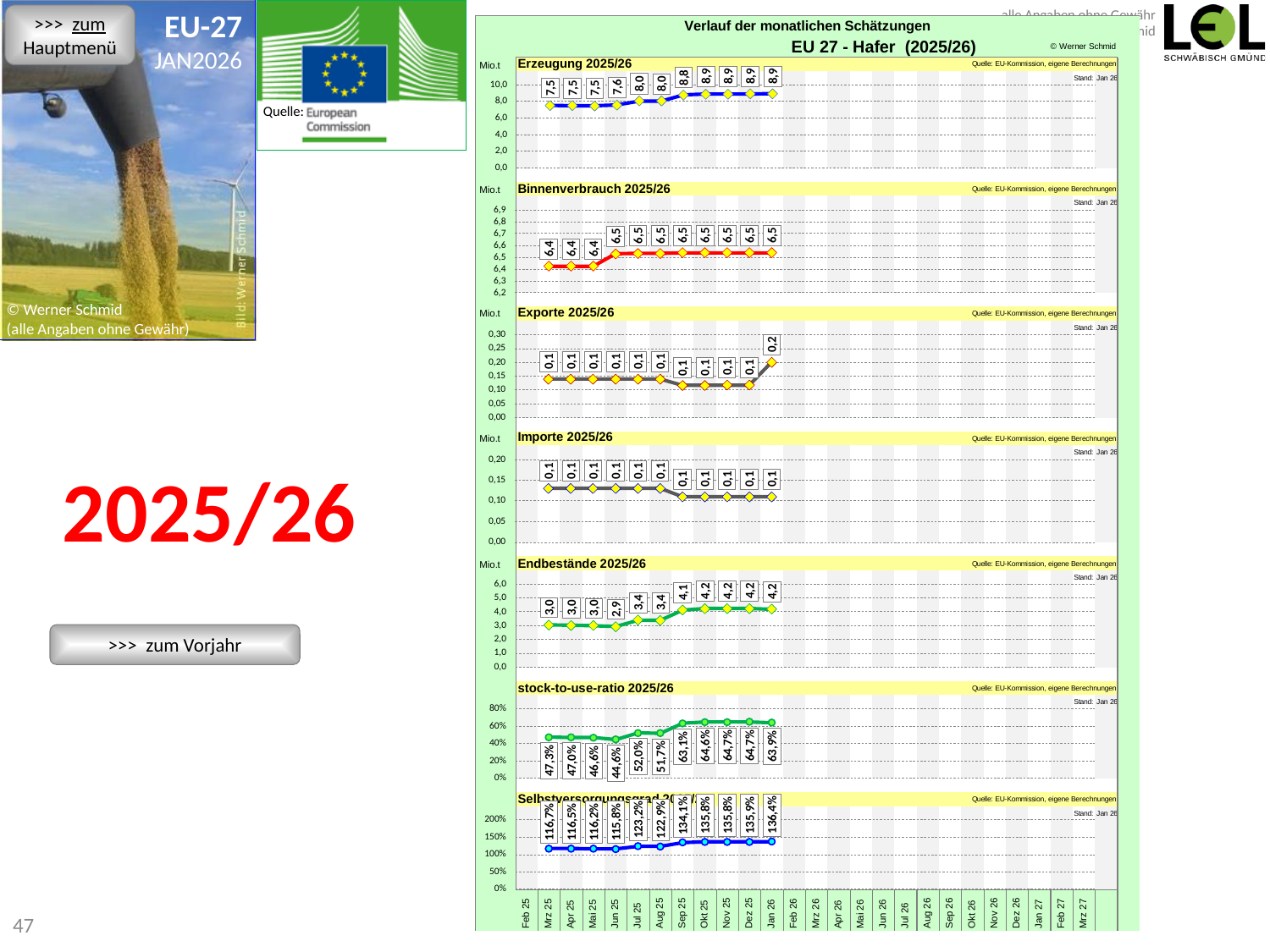
In the stock-to-use-ratio 2025/26 chart, what is the value for Jan 26? 63,9% What kind of charts are shown on the slide? Line charts In the Erzeugung 2025/26 chart, what is the difference between the Jan 26 value (8,9) and the first value in Mrz 25 (7,5)? 1,4 What is the overall title above the charts? EU 27 - Hafer (2025/26) In the Binnenverbrauch 2025/26 chart, what is the value for Jan 26? 6,5 How many separate charts are stacked on the slide? 7 In the Exporte 2025/26 chart, what is the value for Jan 26? 0,2 In the Selbstversorgungsgrad chart, what is the highest value shown? 136,4% In the Erzeugung 2025/26 chart, do the values rise or fall from Mrz 25 to Jan 26? Rise In the Endbestände 2025/26 chart, which is larger, the value for Jun 25 or the value for Jan 26? Jan 26 In the Erzeugung 2025/26 chart, what is the value for Jan 26? 8,9 In the stock-to-use-ratio 2025/26 chart, what is the lowest value shown? 44,6%